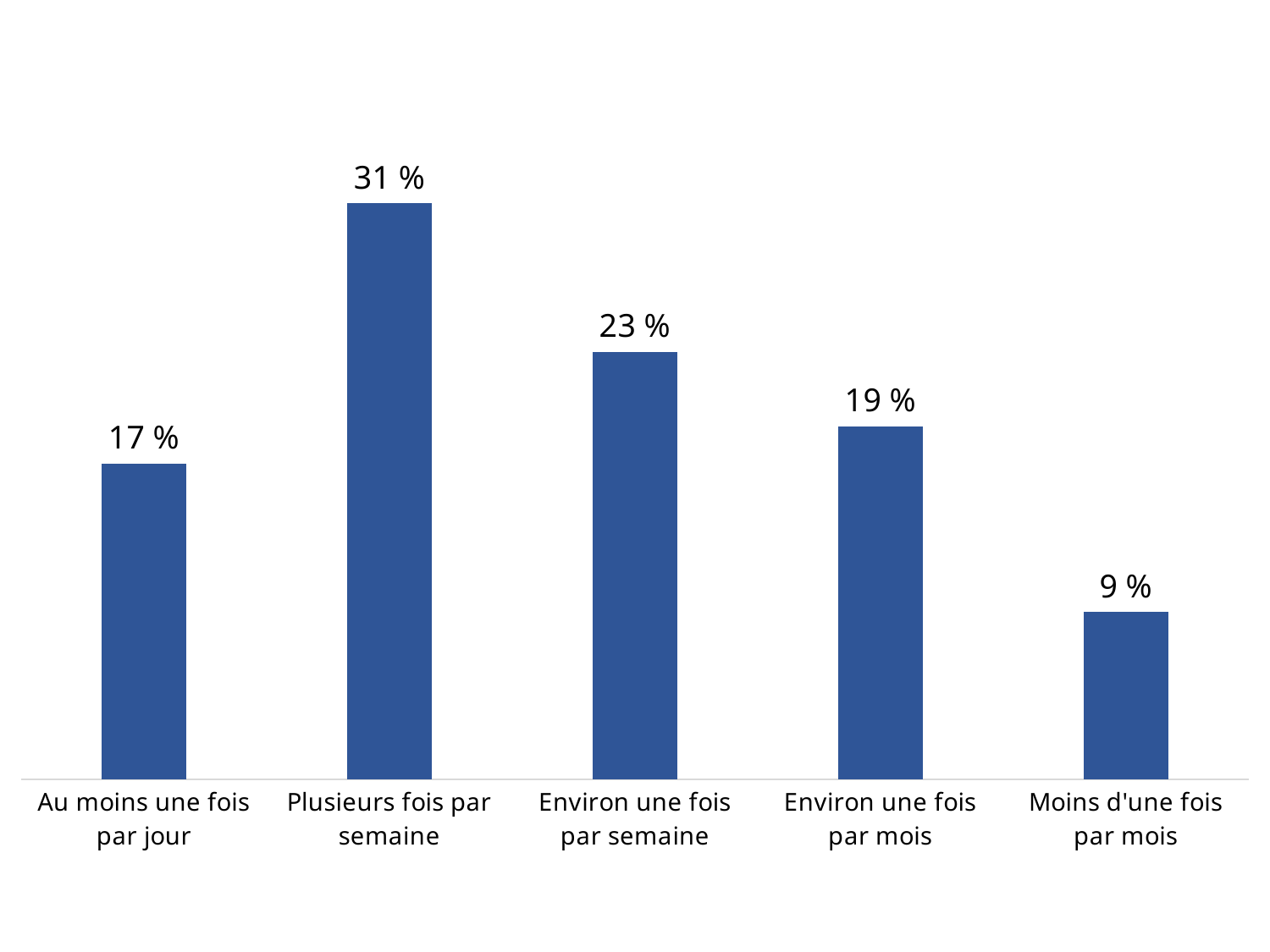
What is the value for "Plusieurs fois par semaine"? 31 % What is the difference between the values for "Environ une fois par mois" and "Moins d'une fois par mois"? 10 % What is the value for "Environ une fois par mois"? 19 % What is the value for "Au moins une fois par jour"? 17 % Which category has the highest value? Plusieurs fois par semaine What is the value for "Moins d'une fois par mois"? 9 % What colour are the bars in the chart? Blue How many categories are shown on the chart? 5 What kind of chart is shown on the slide? Bar chart Which is larger, the value for "Au moins une fois par jour" or the value for "Environ une fois par mois"? Environ une fois par mois What is the difference between the values for "Plusieurs fois par semaine" and "Environ une fois par semaine"? 8 % Which category has the lowest value? Moins d'une fois par mois